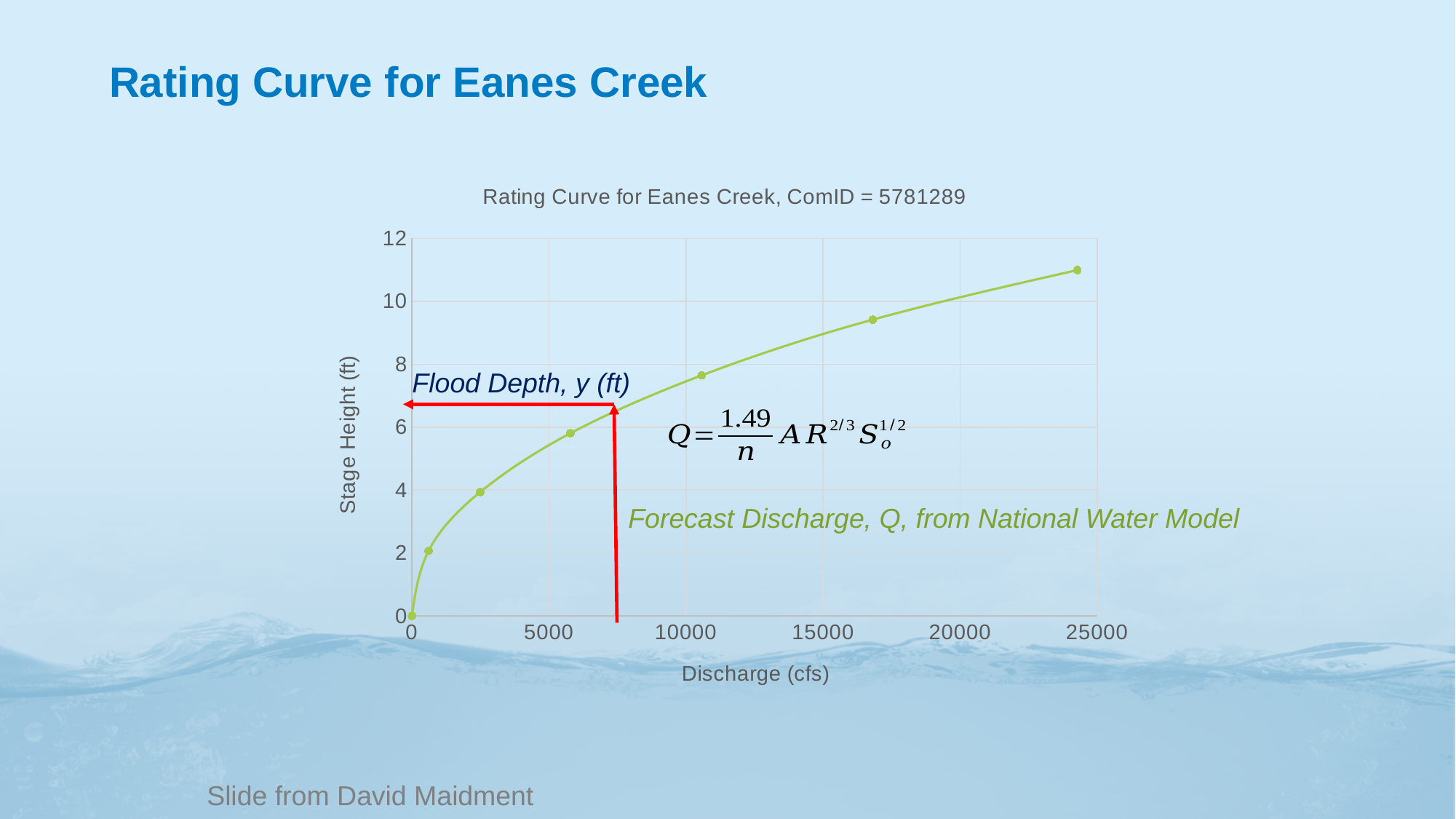
Is the stage height at the highest-discharge point greater or less than 10? greater Is the discharge of the rightmost data point greater or less than 20000 cfs? greater Is the stage height at a discharge of 5000 cfs greater or less than 4? greater Which data point has the highest stage height, the one at the lowest discharge or the one at the highest discharge? the one at the highest discharge How many data points are marked on the curve? 7 What is the label of the x axis? Discharge (cfs) What is the title printed above the chart? Rating Curve for Eanes Creek, ComID = 5781289 Does stage height rise or fall as discharge increases along the x axis? rise What is the highest value shown on the y axis? 12 What kind of chart is shown on the slide? line chart